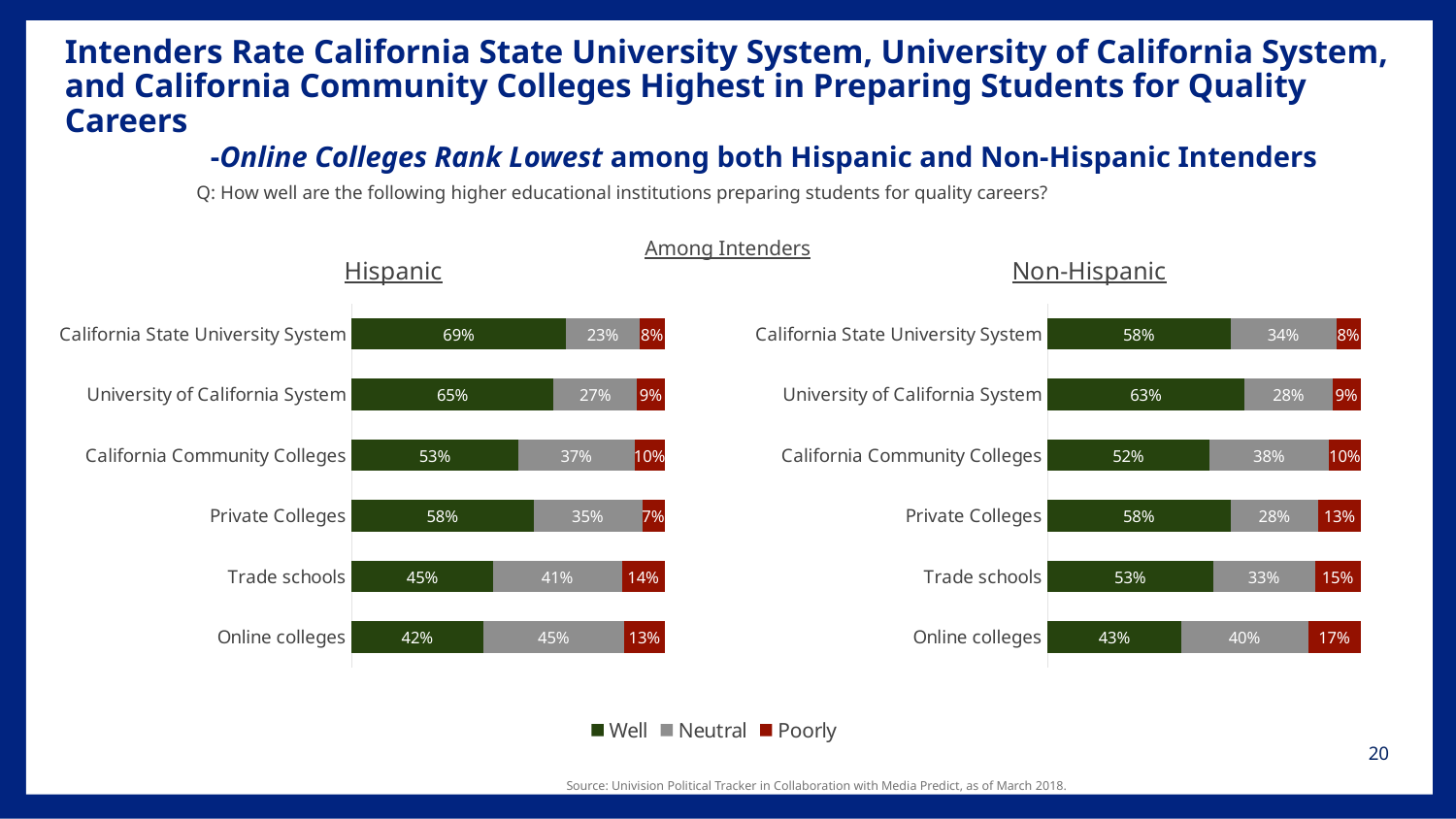
In the Non-Hispanic chart, which institution has the lowest 'Well' percentage? Online colleges In the Non-Hispanic chart, which has a larger 'Poorly' percentage: Trade schools or Private Colleges? Trade schools How many institutions are listed in the Hispanic chart? 6 In the Non-Hispanic chart, what is the 'Neutral' value for California Community Colleges? 38% In the Non-Hispanic chart, what percentage rated Online colleges 'Poorly'? 17% In the Hispanic chart, what is the total of the three segments for Trade schools? 100% Which colour represents the 'Poorly' rating in the legend? Red How many series does the legend list? 3 In the Hispanic chart, what percentage rated the California State University System as preparing students 'Well'? 69% In the Hispanic chart, which institution has the highest 'Well' percentage? California State University System In the Hispanic chart, what is the difference between the 'Well' percentages for the University of California System and Online colleges? 23 percentage points What type of chart is used to show the Hispanic ratings? Stacked bar chart